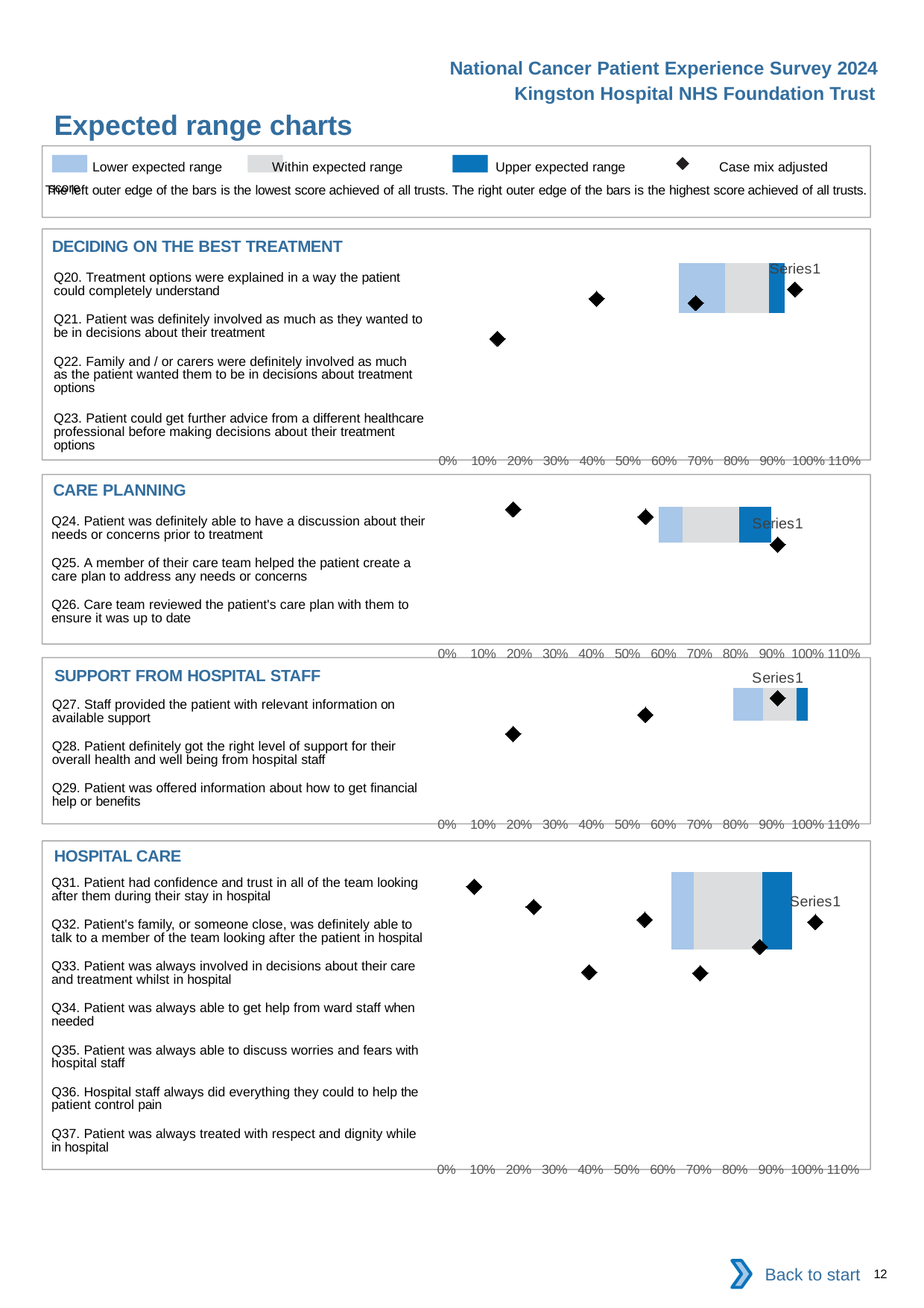
In the SUPPORT FROM HOSPITAL STAFF chart, is the left edge of the expected range bar greater or less than 70%? greater What kind of chart is used in the DECIDING ON THE BEST TREATMENT section? bar chart How many questions are listed in the DECIDING ON THE BEST TREATMENT chart? 4 How many questions are listed in the HOSPITAL CARE chart? 7 In the CARE PLANNING chart, is the right edge of the expected range bar greater or less than 70%? greater What is the highest percentage tick shown on the x axis of the HOSPITAL CARE chart? 110% How many entries does the legend at the top of the slide list? 4 How many questions are listed in the CARE PLANNING chart? 3 According to the legend, what does the diamond marker represent? Case mix adjusted score In the DECIDING ON THE BEST TREATMENT chart, is the left edge of the expected range bar greater or less than 50%? greater